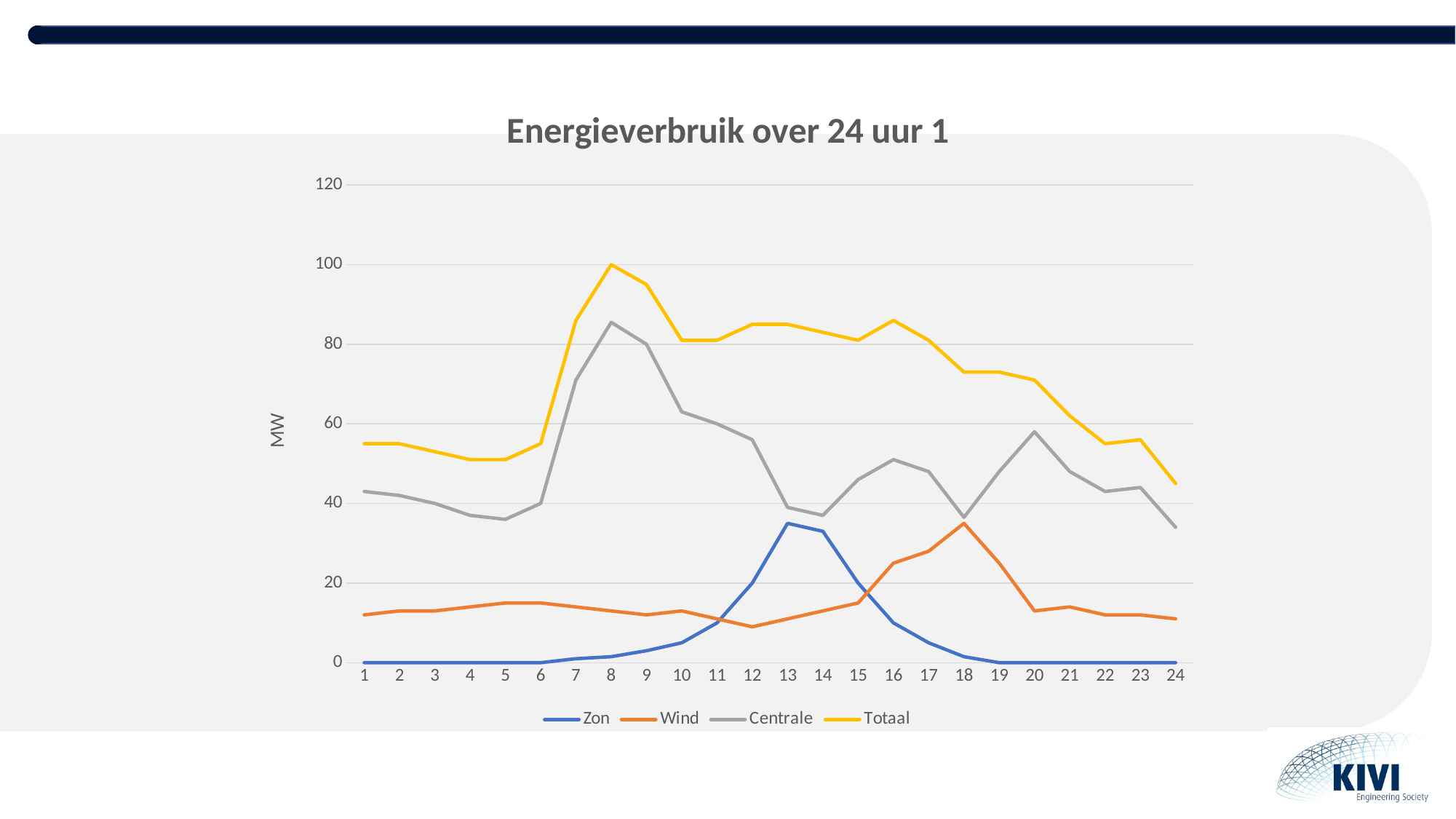
At which hour does the Zon series reach its highest value? 13 At hour 20, which is larger: Centrale or Wind? Centrale How many series does the legend list? 4 Is the value for Centrale at hour 8 greater or less than 80? greater Is the value for Totaal at hour 24 greater or less than 60? less At which hour does the Wind series reach its highest value? 18 What is the label on the y axis? MW At which hour does the Totaal series reach its highest value? 8 What kind of chart is shown on the slide? line chart What is the value of the Totaal series at hour 8? 100 How many hours (points) are plotted along the x axis? 24 What is the value of the Zon series at hour 1? 0